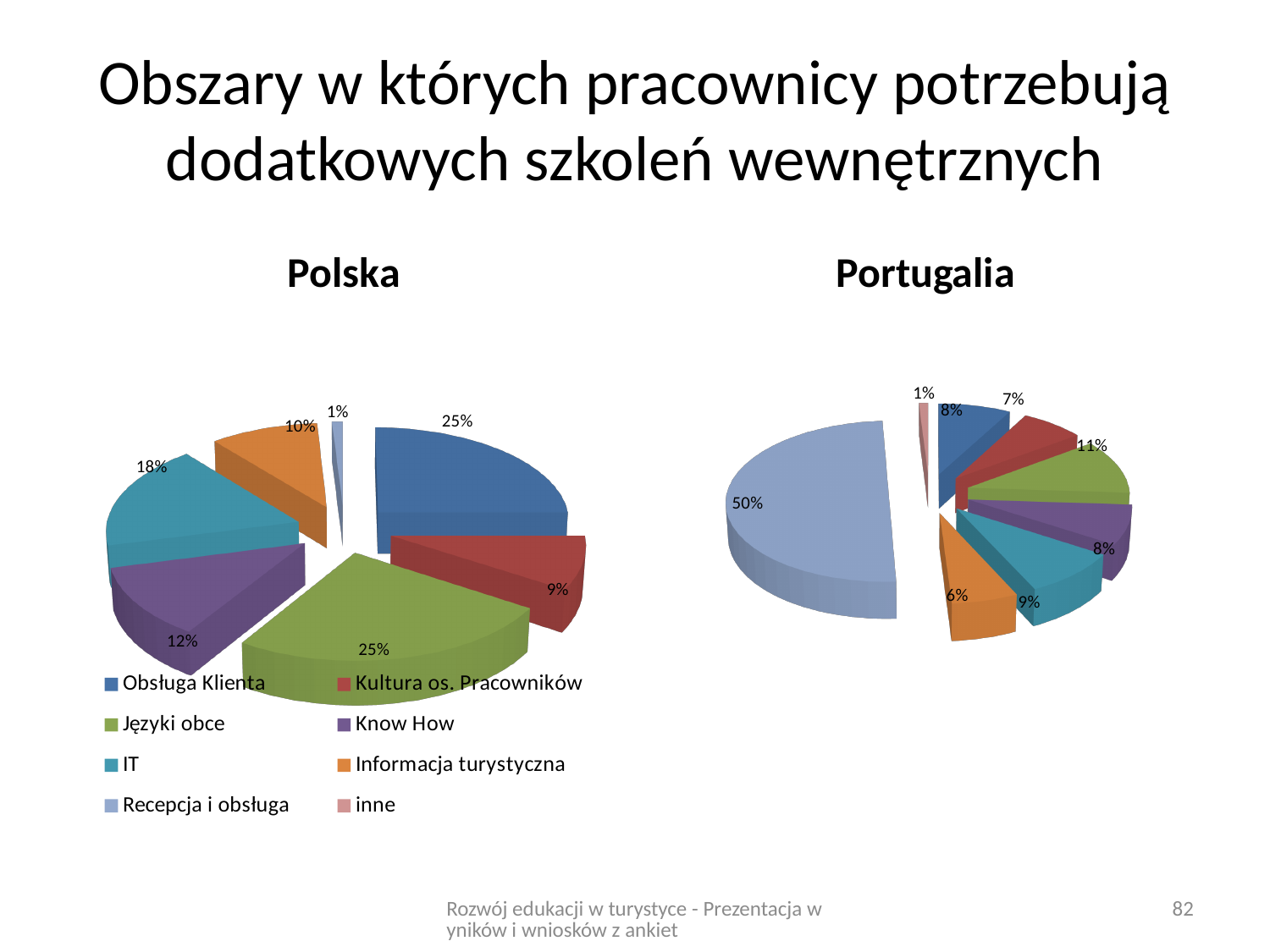
In the Polska pie chart, what share does Know How have? 12% In the Portugalia pie chart, what share does Recepcja i obsługa have? 50% In the Portugalia pie chart, what share does Informacja turystyczna have? 6% In the Polska pie chart, what is the difference between the shares of IT and Informacja turystyczna? 8% How many categories does the legend list? 8 In the Polska pie chart, what share does Obsługa Klienta have? 25% In the Polska pie chart, what share does IT have? 18% In the Polska pie chart, which category has the smallest labelled share? Recepcja i obsługa In the Portugalia pie chart, what share does Języki obce have? 11% What type of chart is used for Polska and Portugalia on this slide? Pie chart In the Portugalia pie chart, which is larger: the share of IT or the share of Kultura os. Pracowników? IT In the Portugalia pie chart, which category has the largest share? Recepcja i obsługa